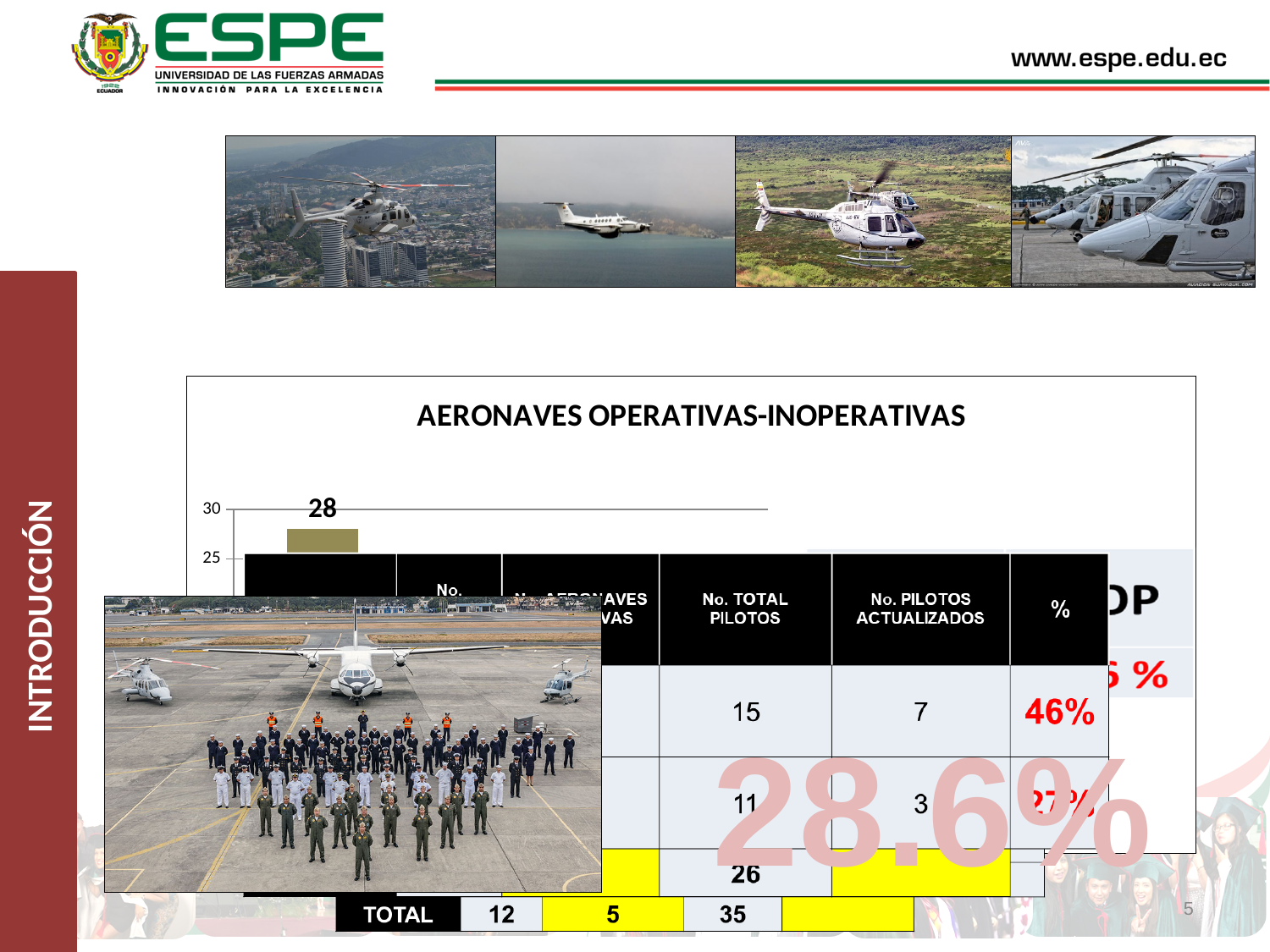
What is the highest tick value shown on the y axis of the 'AERONAVES OPERATIVAS-INOPERATIVAS' chart? 30 In the 'AERONAVES OPERATIVAS-INOPERATIVAS' chart, is the value of the visible left bar greater or less than 25? greater What kind of chart is the 'AERONAVES OPERATIVAS-INOPERATIVAS' chart? bar chart In the 'AERONAVES OPERATIVAS-INOPERATIVAS' chart, is the value of the visible left bar greater or less than 30? less In the 'AERONAVES OPERATIVAS-INOPERATIVAS' chart, what value is printed on the visible bar at the left? 28 What is the title of the chart on the slide? AERONAVES OPERATIVAS-INOPERATIVAS